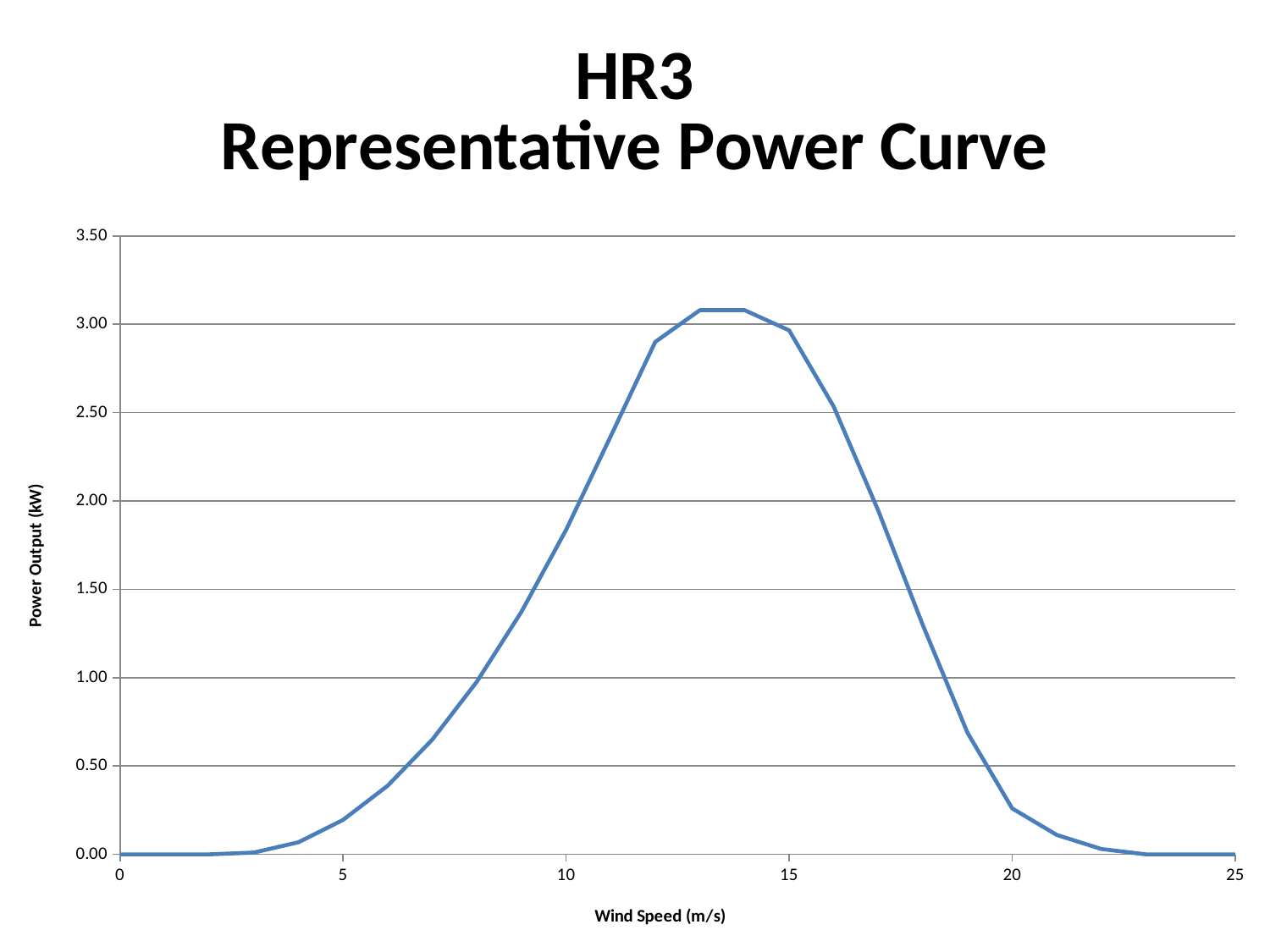
Is the peak power output on the curve greater or less than 3.00? greater Is the power output at a wind speed of 10 m/s greater or less than 1.50? greater Is the power output at a wind speed of 12 m/s greater or less than 2.50? greater What is the power output at a wind speed of 0 m/s? 0.00 What kind of chart is shown on the slide? line chart What is the title of the chart? HR3 Representative Power Curve What is the label of the vertical axis? Power Output (kW) Does the power output rise or fall as wind speed increases from 15 m/s to 22 m/s? fall Does the power output rise or fall as wind speed increases from 5 m/s to 12 m/s? rise